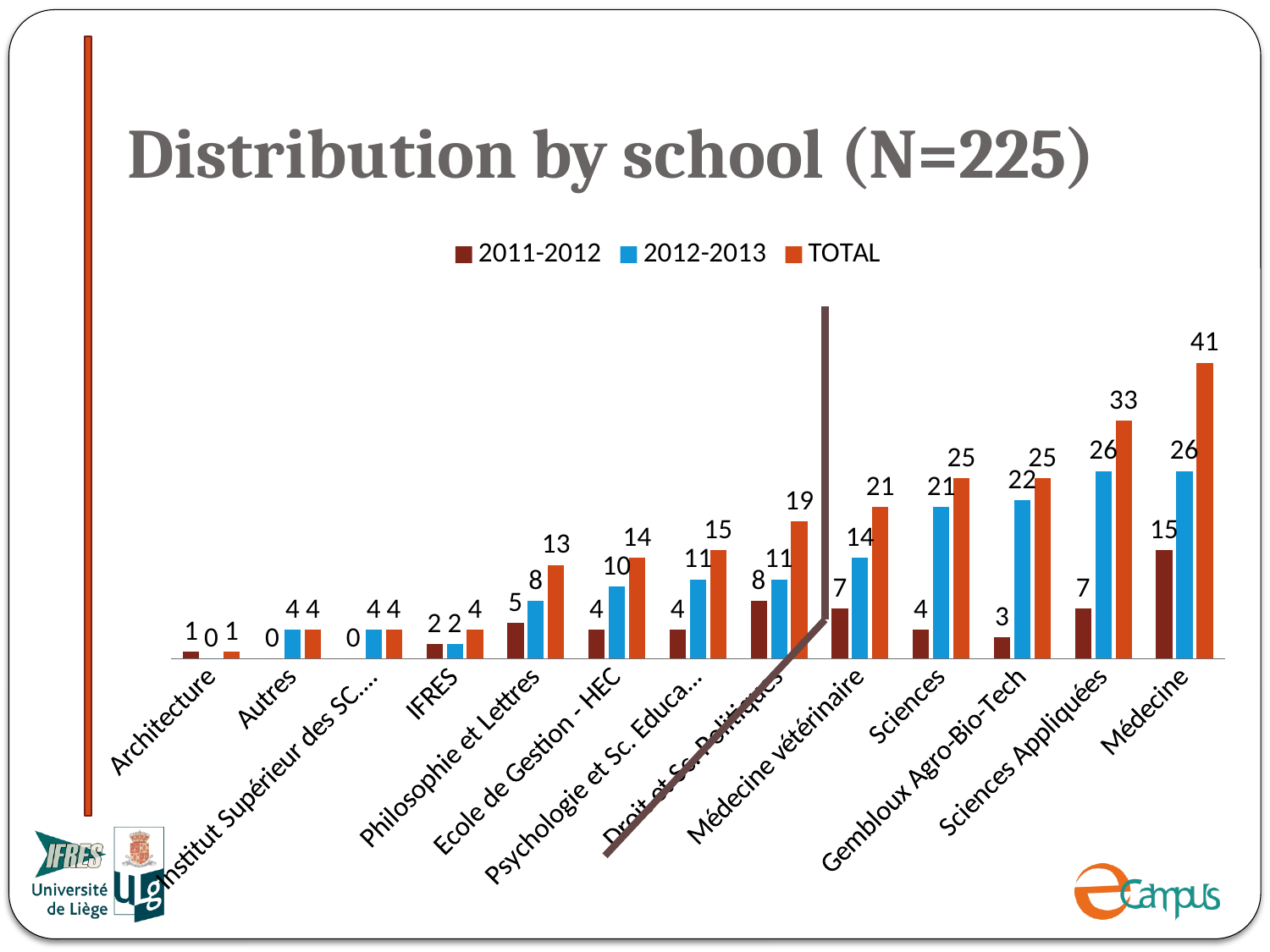
Which school has the highest TOTAL value? Médecine Which school has the highest 2011-2012 value? Médecine How many series does the legend list? 3 What is the title of the chart on the slide? Distribution by school (N=225) Which is larger, the 2012-2013 value for Ecole de Gestion - HEC or for Philosophie et Lettres? Ecole de Gestion - HEC What is the difference between the TOTAL values for Sciences Appliquées and Médecine vétérinaire? 12 What is the 2011-2012 value for Philosophie et Lettres? 5 How many schools (categories) are shown on the x axis? 13 What kind of chart is shown on the slide? Bar chart What is the 2011-2012 value for Gembloux Agro-Bio-Tech? 3 What is the 2012-2013 value for Sciences? 21 What is the TOTAL value for Médecine? 41